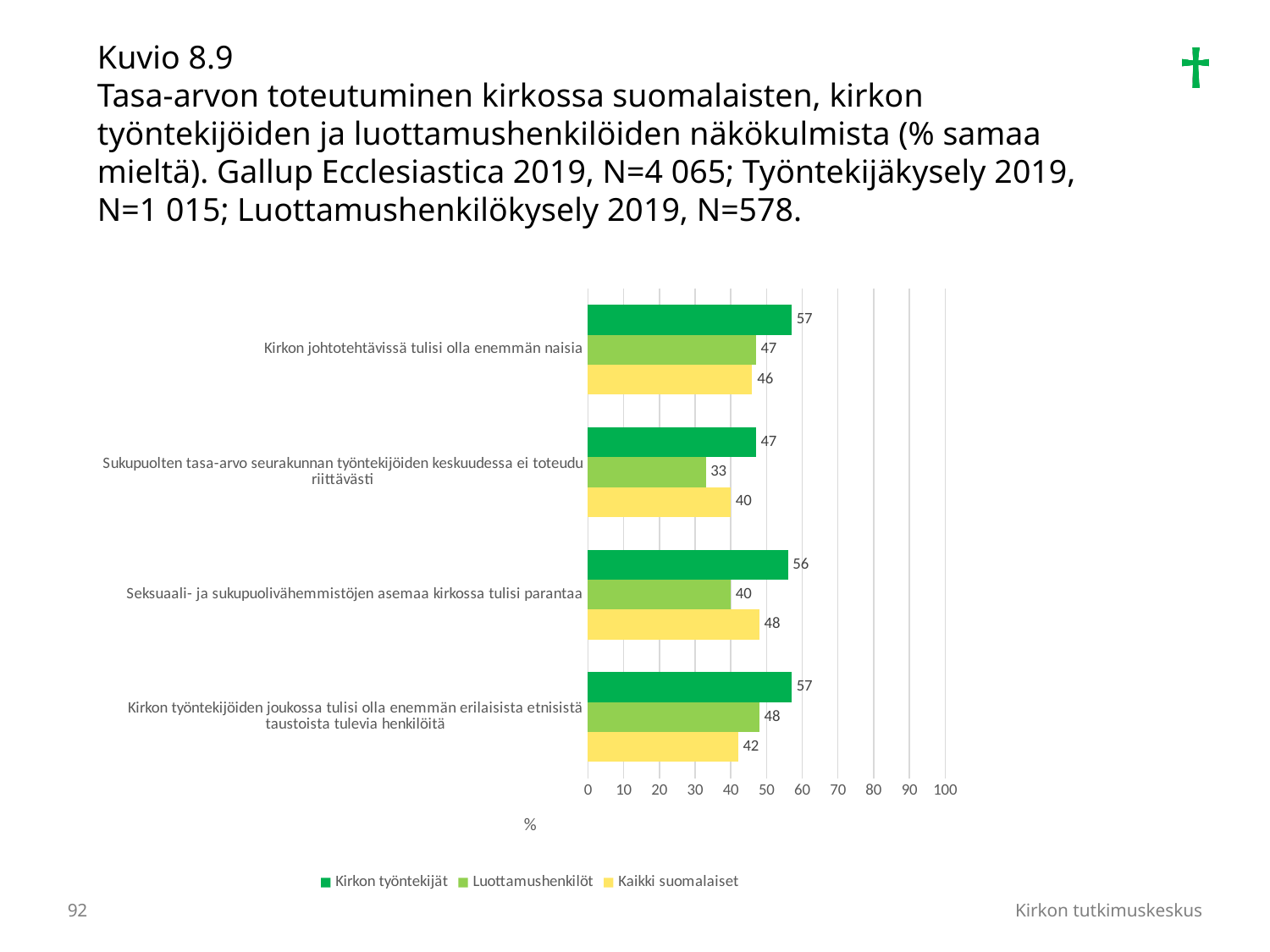
What is the difference between the Kirkon työntekijät and Luottamushenkilöt values for 'Seksuaali- ja sukupuolivähemmistöjen asemaa kirkossa tulisi parantaa'? 16 What is the value for Kirkon työntekijät for 'Kirkon johtotehtävissä tulisi olla enemmän naisia'? 57 Which colour represents the Kaikki suomalaiset series in the chart? yellow Which statement has the lowest value for Luottamushenkilöt? Sukupuolten tasa-arvo seurakunnan työntekijöiden keskuudessa ei toteudu riittävästi Is the Kirkon työntekijät value for 'Sukupuolten tasa-arvo seurakunnan työntekijöiden keskuudessa ei toteudu riittävästi' greater or less than 50? less What is the value for Luottamushenkilöt for 'Sukupuolten tasa-arvo seurakunnan työntekijöiden keskuudessa ei toteudu riittävästi'? 33 What is the value for Kaikki suomalaiset for 'Seksuaali- ja sukupuolivähemmistöjen asemaa kirkossa tulisi parantaa'? 48 Which statement has the highest value for Kaikki suomalaiset? Seksuaali- ja sukupuolivähemmistöjen asemaa kirkossa tulisi parantaa What type of chart is shown on the slide? bar chart How many series does the legend list? 3 For 'Kirkon työntekijöiden joukossa tulisi olla enemmän erilaisista etnisistä taustoista tulevia henkilöitä', which is larger: the Luottamushenkilöt value or the Kaikki suomalaiset value? Luottamushenkilöt How many categories (statements) are shown in the chart? 4